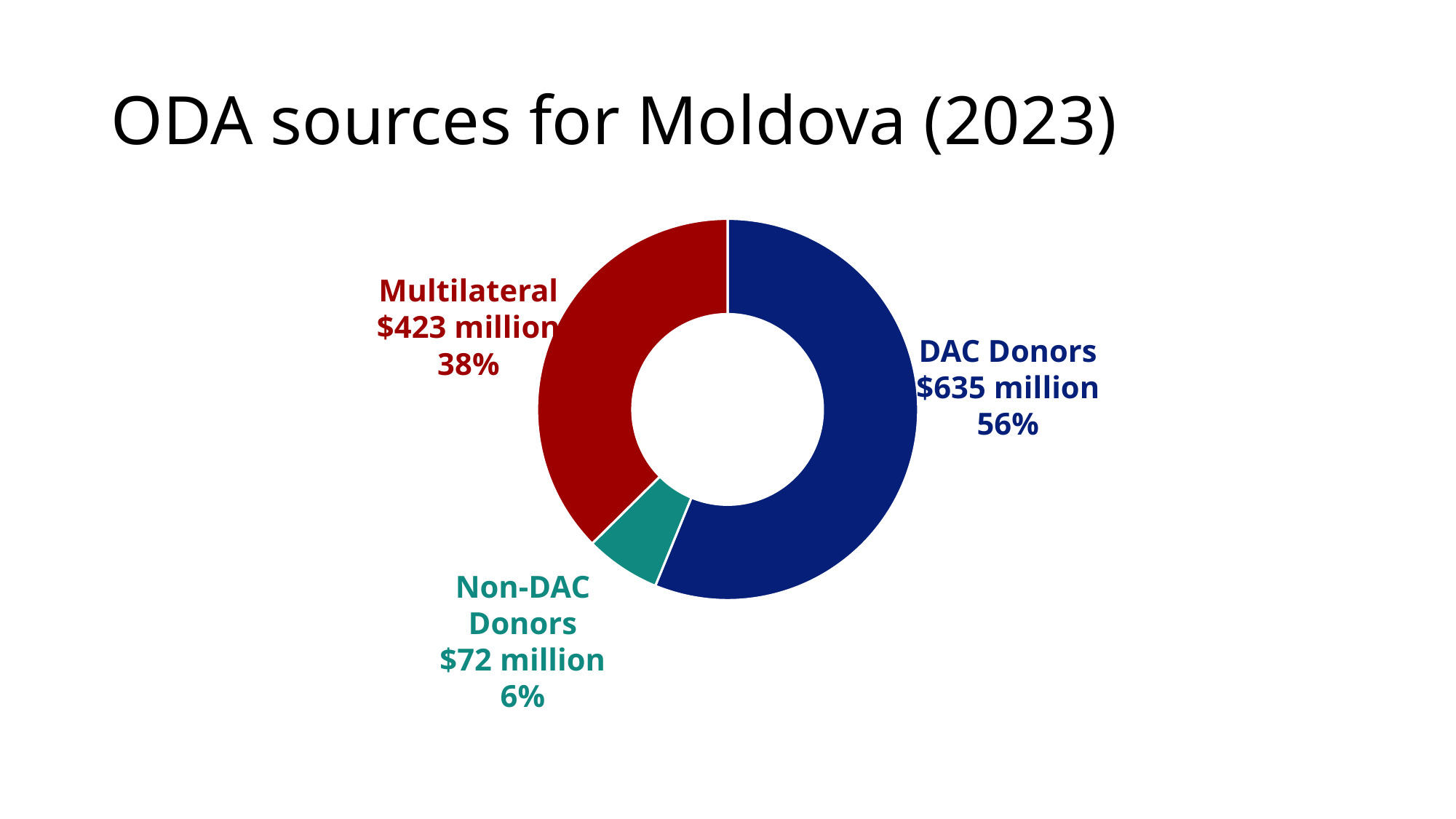
What is the ODA value for Non-DAC Donors? $72 million What is the ODA value for DAC Donors? $635 million Which ODA source has the smallest share? Non-DAC Donors What is the difference in ODA between DAC Donors and Multilateral sources? $212 million How many ODA source categories are shown in the chart? 3 What share of ODA comes from Multilateral sources? 38% Which ODA source has the largest share? DAC Donors What kind of chart is shown on the slide? Pie chart (donut) Which is larger, the ODA from Multilateral sources or from Non-DAC Donors? Multilateral What share of ODA comes from Non-DAC Donors? 6% What is the ODA value for Multilateral sources? $423 million What is the title of the slide? ODA sources for Moldova (2023)